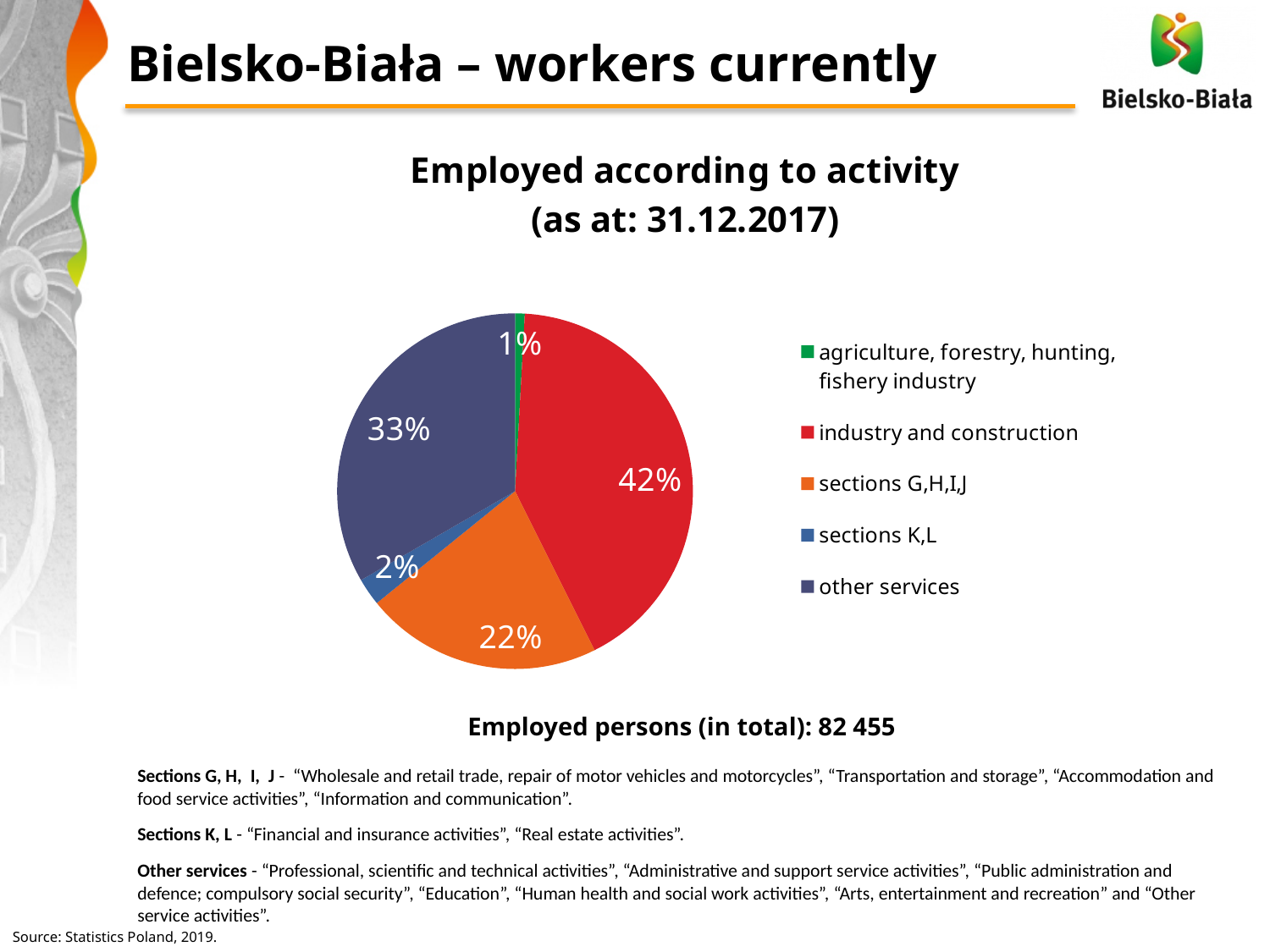
Which has a larger share: sections G,H,I,J or other services? other services What is the difference in percentage points between industry and construction and other services? 9 percentage points Which activity has the largest share of employed persons? industry and construction What share of employed persons works in sections K,L? 2% How many categories does the legend list? 5 What share of employed persons works in agriculture, forestry, hunting, fishery industry? 1% What share of employed persons works in industry and construction? 42% What kind of chart is shown on the slide? pie chart Which activity has the smallest share of employed persons? agriculture, forestry, hunting, fishery industry What is the total number of employed persons stated below the chart? 82 455 What share of employed persons works in sections G,H,I,J? 22% What share of employed persons works in other services? 33%